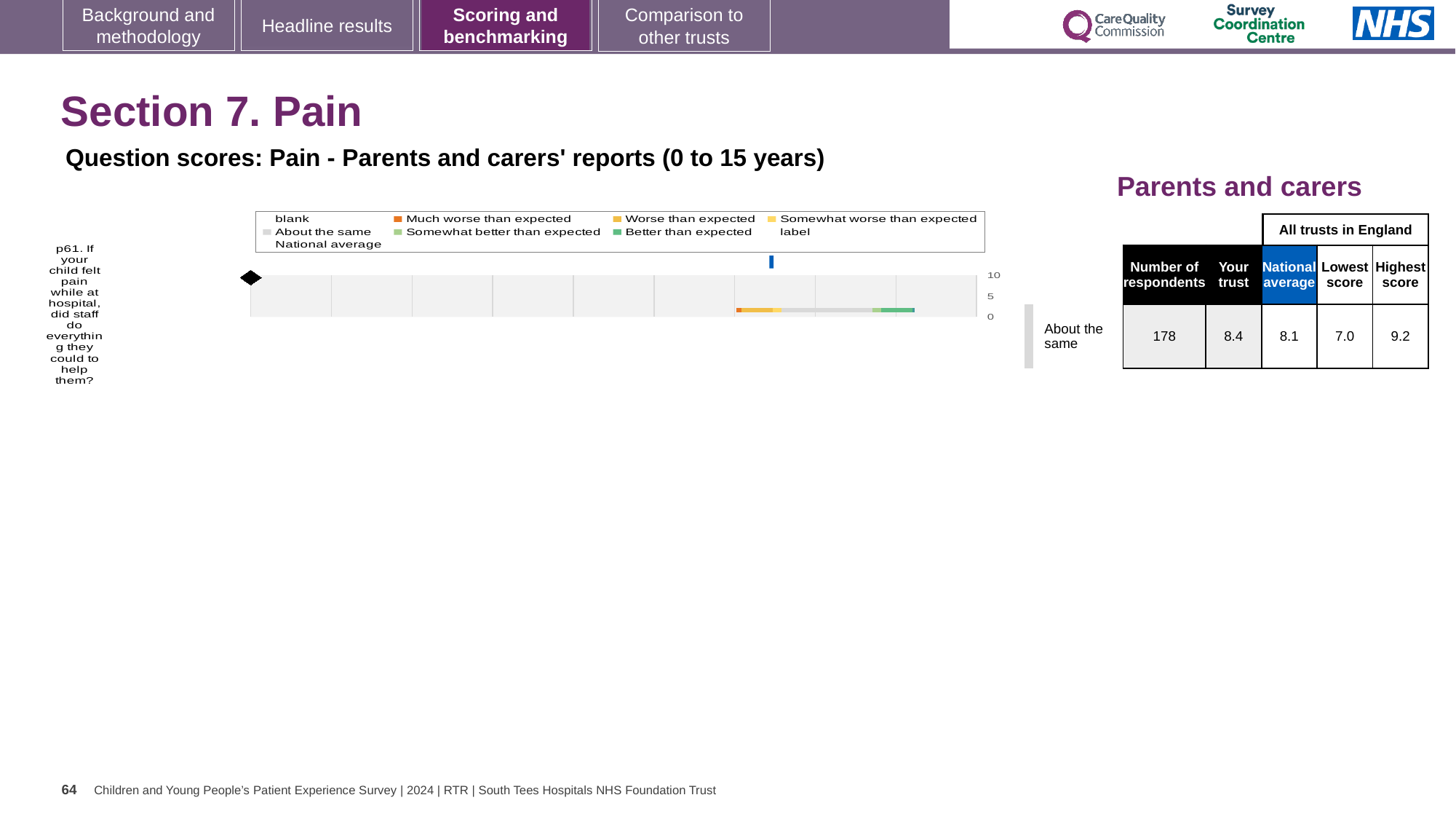
What kind of chart is shown on the slide? bar chart What is the 'Your trust' score for question p61 shown alongside the chart? 8.4 What is the national average score for question p61 shown alongside the chart? 8.1 How many survey questions are plotted in the chart? 1 How many respondents answered question p61? 178 Which is larger for question p61, the trust's score or the national average? the trust's score How is the trust's result for question p61 categorised relative to expectations? About the same What is the highest score among all trusts in England for question p61? 9.2 What is the lowest score among all trusts in England for question p61? 7.0 What is the highest value shown on the chart's axis? 10 Which question is plotted in the chart? p61. If your child felt pain while at hospital, did staff do everything they could to help them? What is the difference between the trust's score and the national average for question p61? 0.3